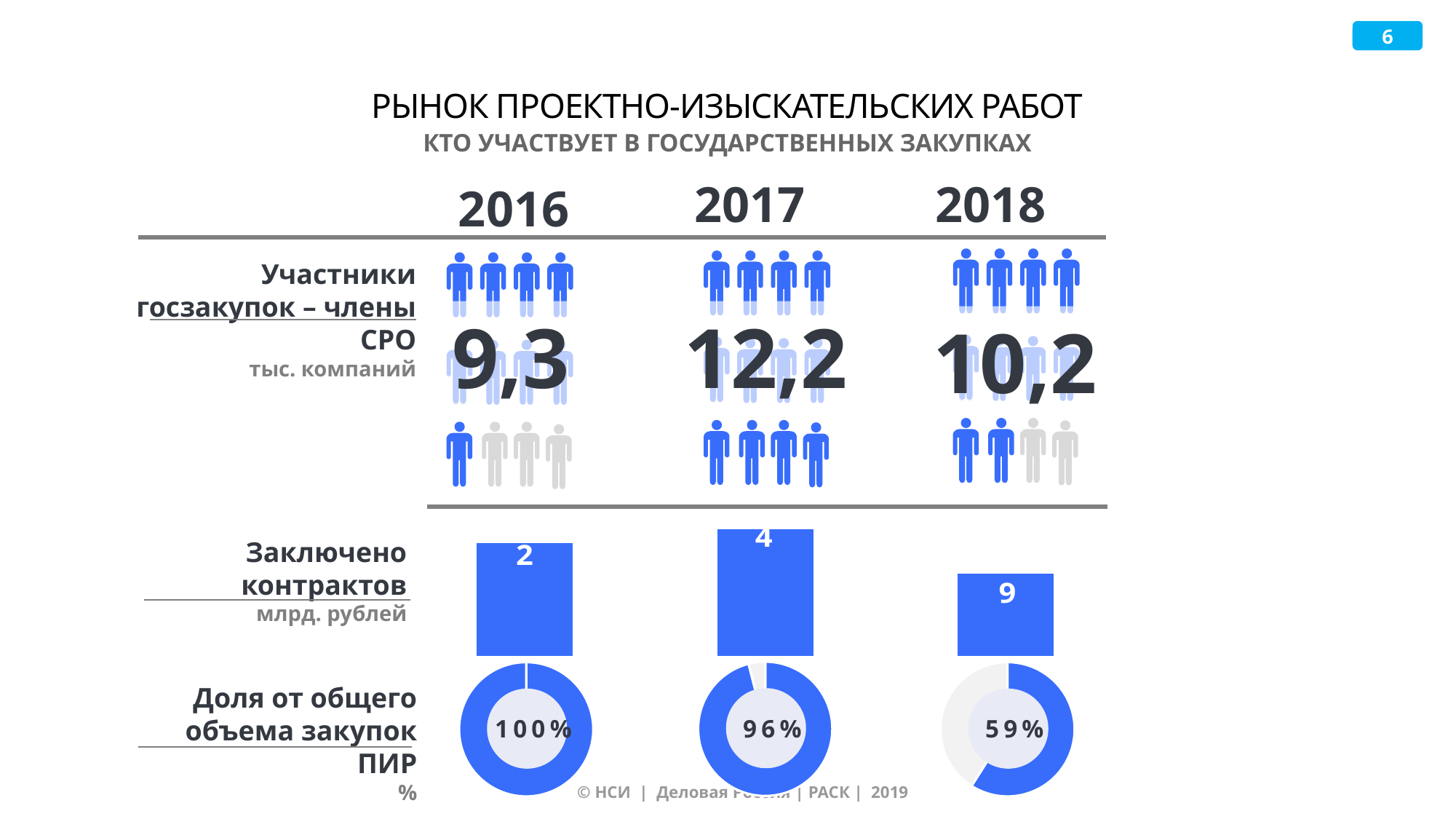
Does the share of the total volume of design and survey work procurement rise or fall from 2016 to 2018? fall Which year has the lowest number of participants in state procurement (SRO members)? 2016 Which year has the highest value of contracts concluded, according to the printed labels? 2018 What is the number of participants in state procurement (SRO members) in 2017, in thousand companies? 12,2 By how many billion rubles does the value of contracts concluded in 2018 exceed that of 2017? 5 What is the number of participants in state procurement (SRO members) in 2016, in thousand companies? 9,3 What is the share of the total volume of design and survey work procurement in 2017? 96% Which year has the highest number of participants in state procurement (SRO members)? 2017 What is the value of contracts concluded in 2016, in billion rubles? 2 How many years are shown on the slide? 3 What is the share of the total volume of design and survey work procurement in 2018? 59% What is the value of contracts concluded in 2018, in billion rubles? 9